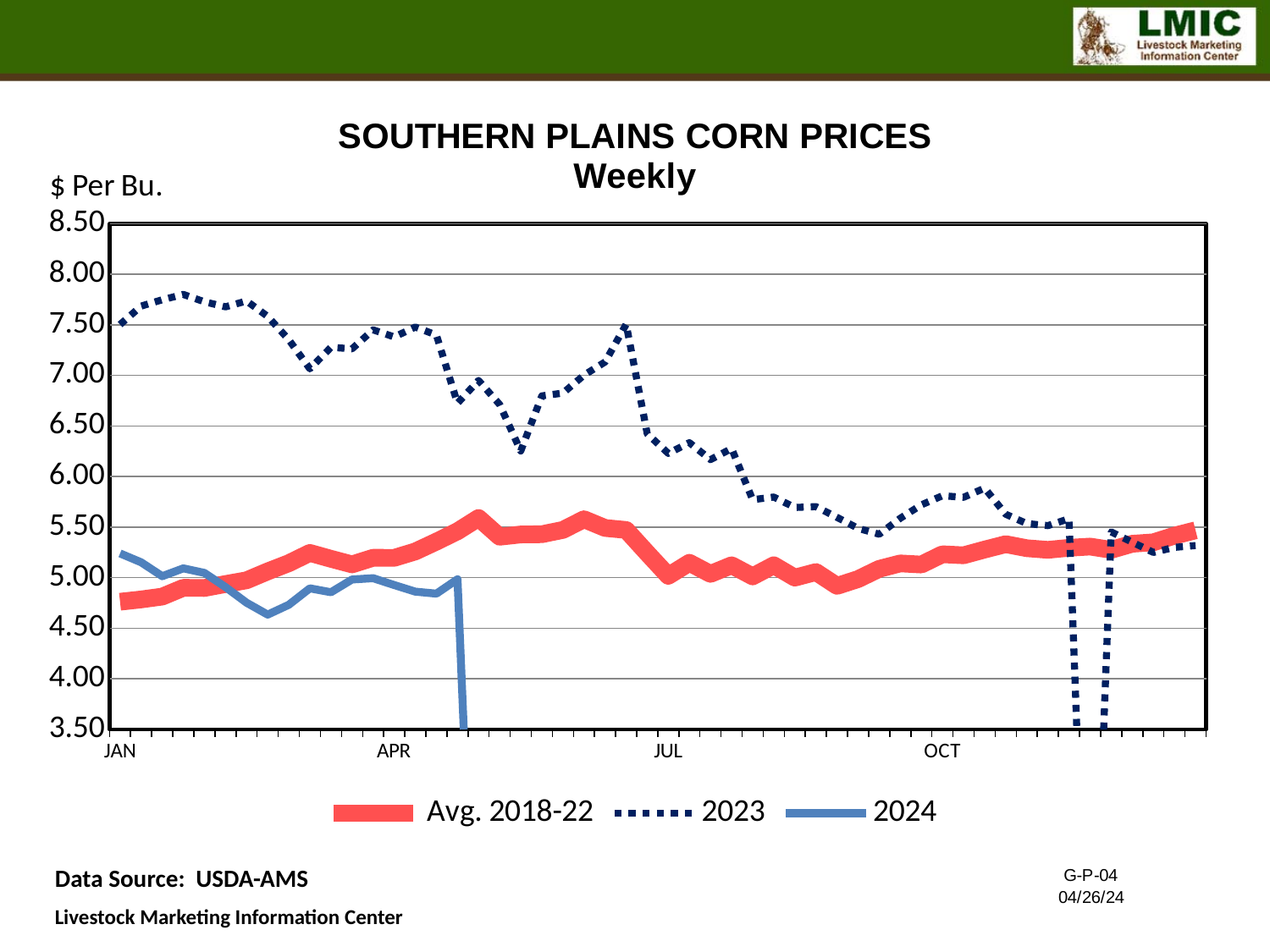
How many month labels are shown on the x axis? 4 At JAN, which series has the higher value: 2023 or Avg. 2018-22? 2023 What kind of chart is shown on the slide? line chart Is the 2024 value at JAN greater or less than 5.00? greater What is the title of the chart? SOUTHERN PLAINS CORN PRICES Weekly Is the 2023 value at OCT greater or less than 5.50? greater At JAN, which series has the higher value: 2024 or Avg. 2018-22? 2024 How many series does the legend list? 3 Does the 2023 series generally rise or fall from JAN to OCT? fall Is the 2023 value at JAN greater or less than 7.00? greater What unit is shown on the y axis of the chart? $ Per Bu.